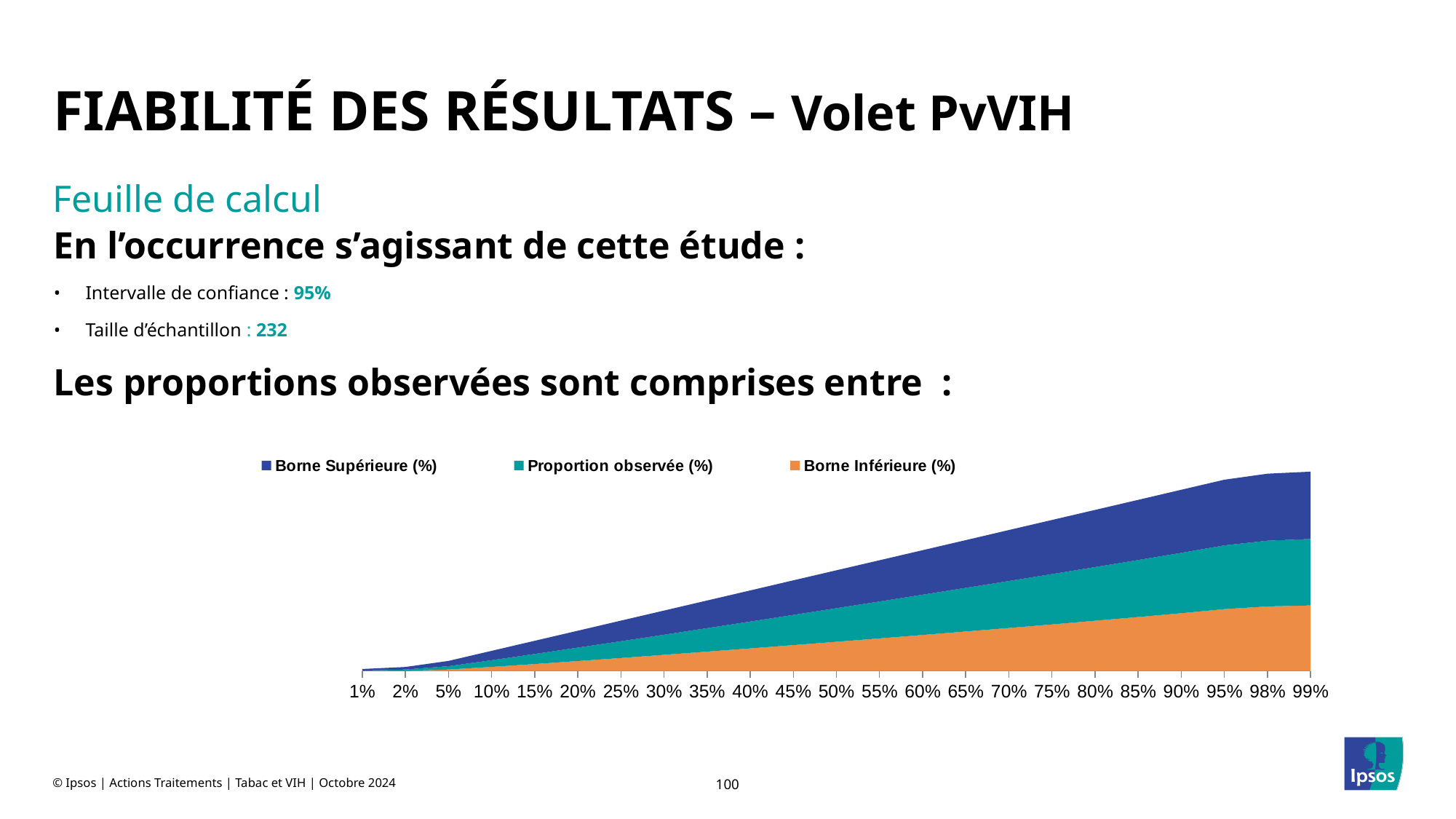
What kind of chart is shown on the slide? Stacked area chart Which series in the chart is shown in orange? Borne Inférieure (%) How many categories are shown along the x axis of the chart? 23 How many series does the chart legend list? 3 Which series is listed first in the chart legend? Borne Supérieure (%) What is the first category label on the x axis of the chart? 1% What is the last category label on the x axis of the chart? 99% At which x-axis category does the stacked area reach its highest point? 99% Do the plotted values rise or fall as you move from left to right along the x axis? Rise At which x-axis category is the stacked area at its lowest? 1%